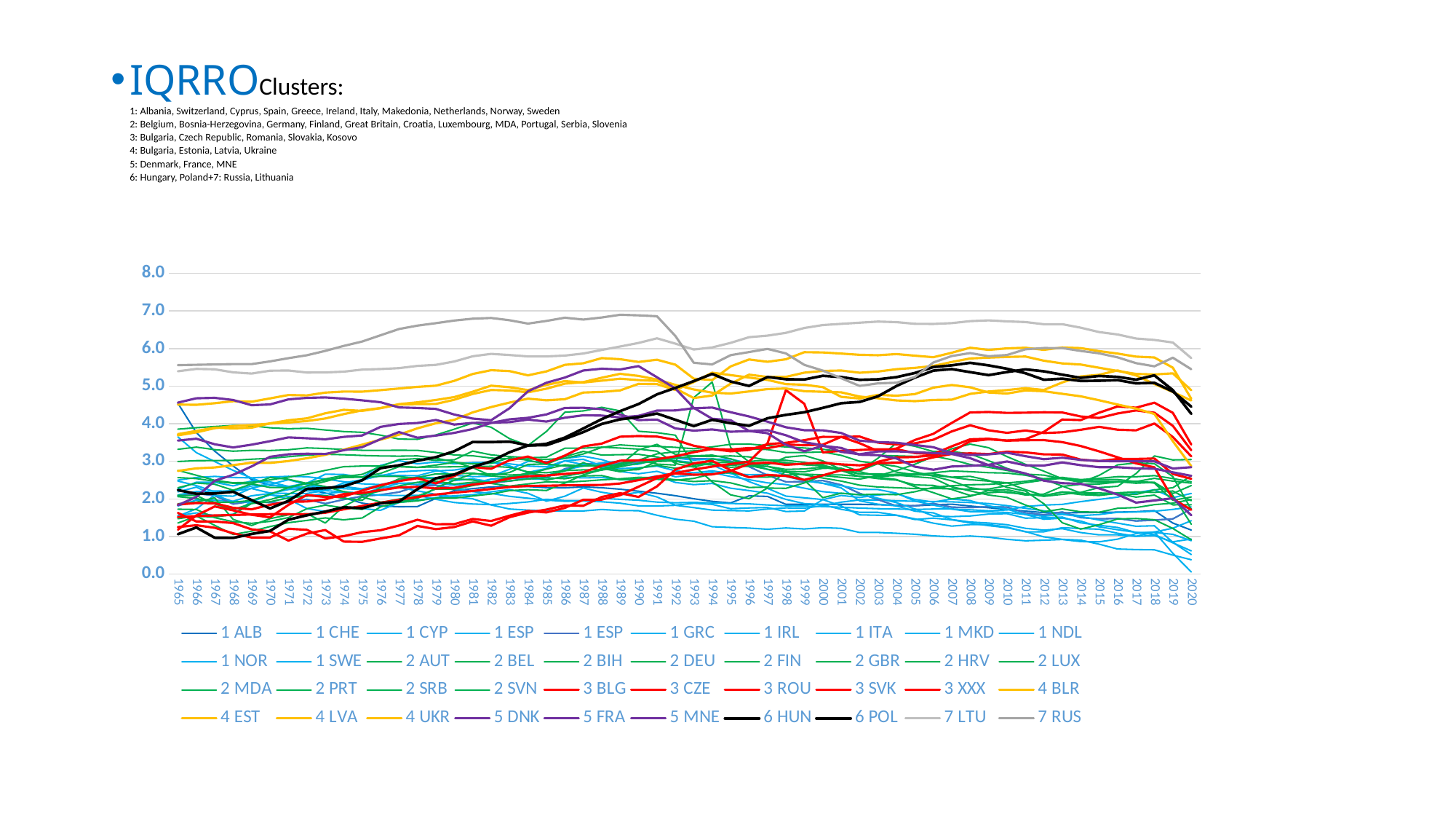
What is the highest value shown on the y axis of the chart? 8.0 How many series does the chart's legend list? 40 Does the value for 6 POL generally rise or fall between 1965 and 2020? rise Is the value for 3 CZE in 1975 greater or less than 3.0? less Is the value for 4 UKR in 2010 greater or less than 4.0? greater Is the value for 6 HUN in 1965 greater or less than 3.0? less What is the first year shown on the x axis of the chart? 1965 How many years are plotted along the x axis of the chart? 56 What kind of chart is shown on the slide? line chart